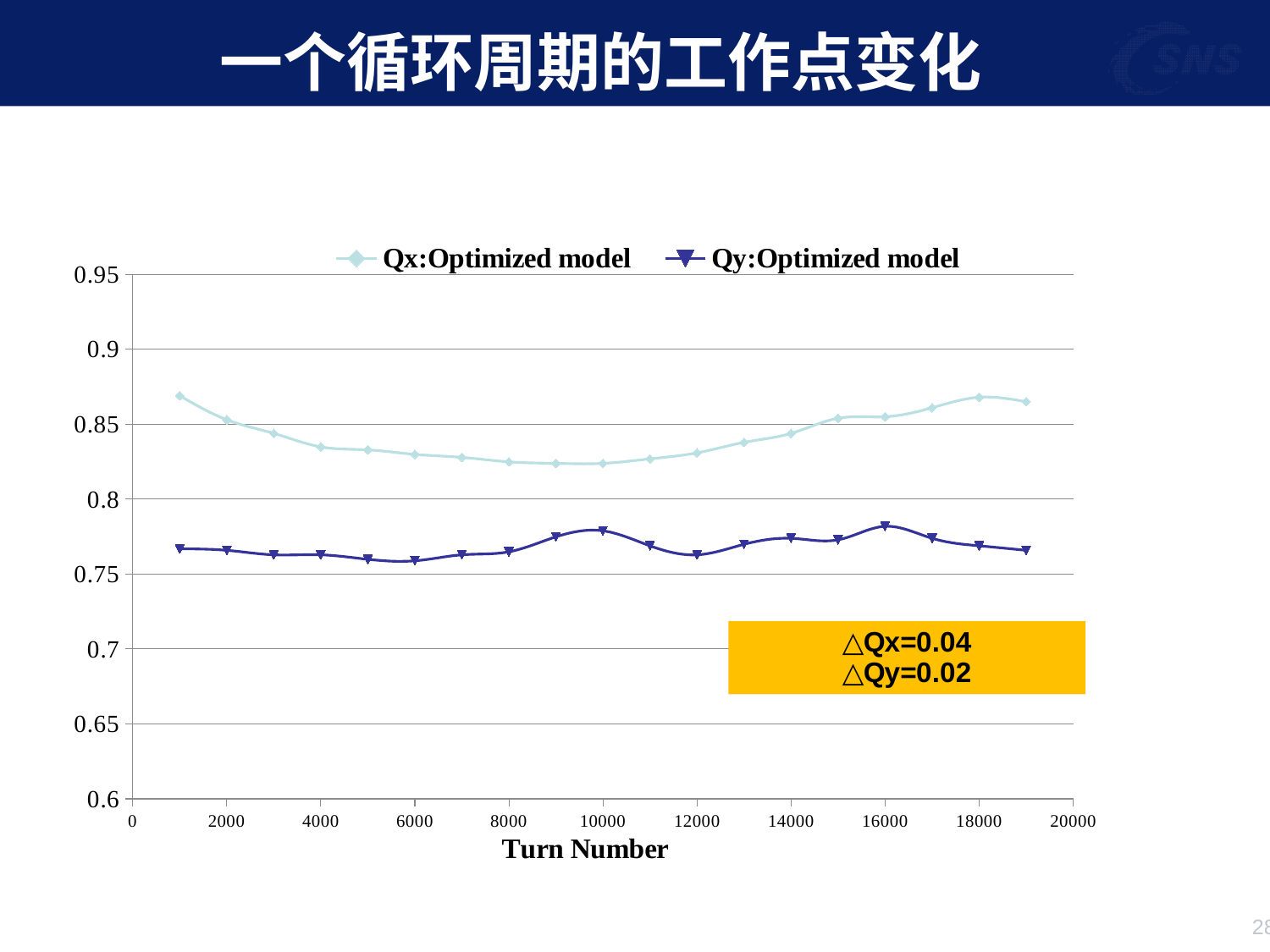
What are the two legend entries? Qx:Optimized model and Qy:Optimized model How many series does the legend list? 2 What kind of chart is shown on the slide? line chart Is the value of Qx:Optimized model at turn 1000 greater or less than 0.85? greater What is the title of the x axis? Turn Number Is the value of Qx:Optimized model at turn 9000 greater or less than 0.85? less How many data points are plotted for the Qx:Optimized model series? 19 At turn 10000, which series has the larger value, Qx:Optimized model or Qy:Optimized model? Qx:Optimized model Is the value of Qy:Optimized model at turn 16000 greater or less than 0.75? greater Does the Qx:Optimized model series rise or fall between turn 1000 and turn 9000? fall Does the Qx:Optimized model series rise or fall between turn 10000 and turn 18000? rise